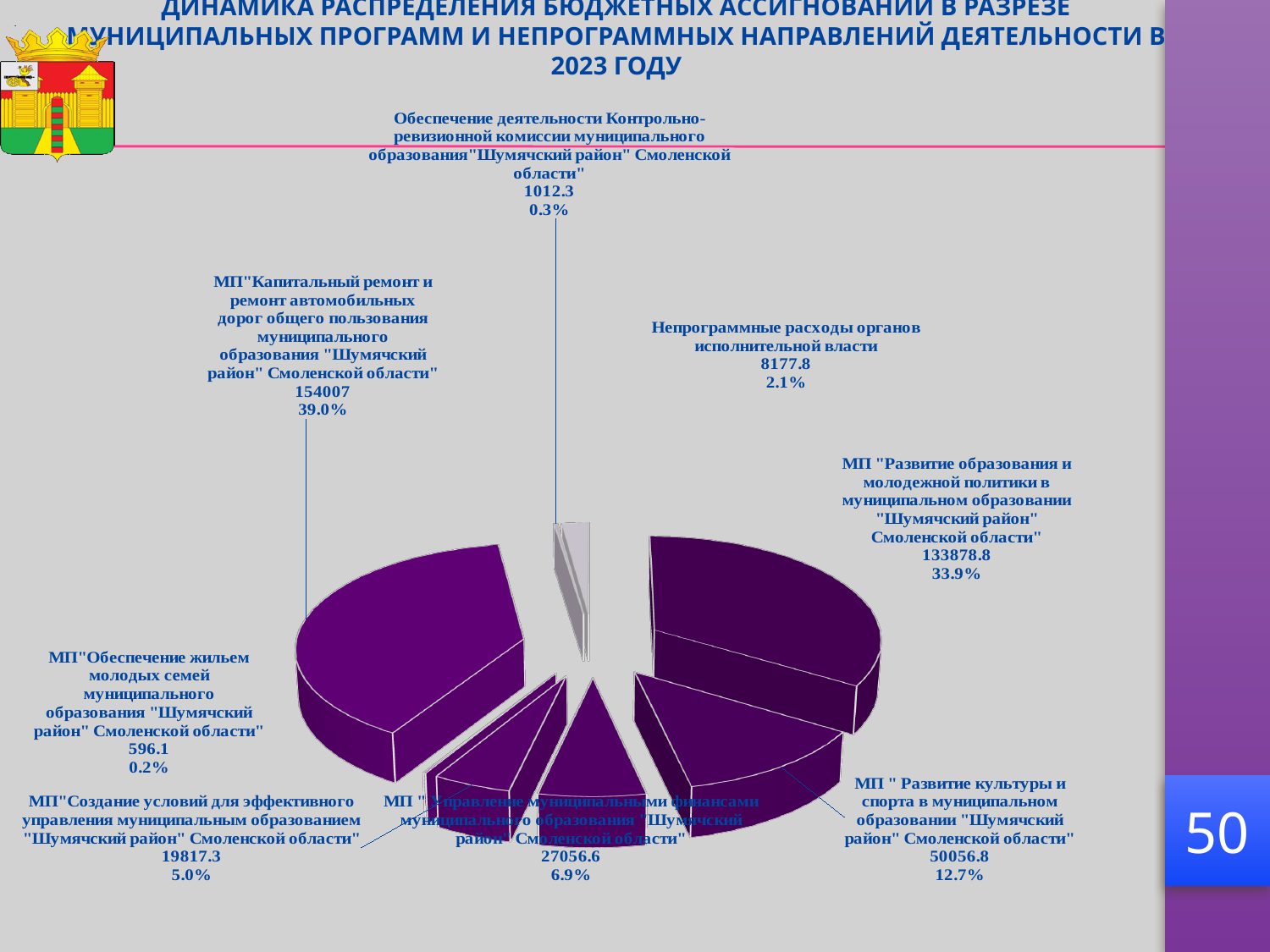
What is the value for Непрограммные расходы органов исполнительной власти? 8177.8 Which category has the largest slice of the pie? МП "Капитальный ремонт и ремонт автомобильных дорог общего пользования муниципального образования "Шумячский район" Смоленской области" What year does the chart title say the budget allocation distribution refers to? 2023 What is the difference between the value for МП "Развитие культуры и спорта" (50056.8) and the value for МП "Управление муниципальными финансами" (27056.6)? 23000.2 Which is larger: the value for МП "Управление муниципальными финансами" or the value for МП "Создание условий для эффективного управления муниципальным образованием"? МП "Управление муниципальными финансами" What is the value for МП "Капитальный ремонт и ремонт автомобильных дорог общего пользования муниципального образования "Шумячский район" Смоленской области"? 154007 What share of the pie does МП "Развитие культуры и спорта в муниципальном образовании "Шумячский район" Смоленской области" represent? 12.7% What is the value for Обеспечение деятельности Контрольно-ревизионной комиссии муниципального образования "Шумячский район" Смоленской области? 1012.3 Which category has the smallest slice of the pie? МП "Обеспечение жильем молодых семей муниципального образования "Шумячский район" Смоленской области" What share of the pie does МП "Развитие образования и молодежной политики в муниципальном образовании "Шумячский район" Смоленской области" represent? 33.9% How many slices (categories) does the pie chart have? 8 What kind of chart is shown on the slide? Pie chart